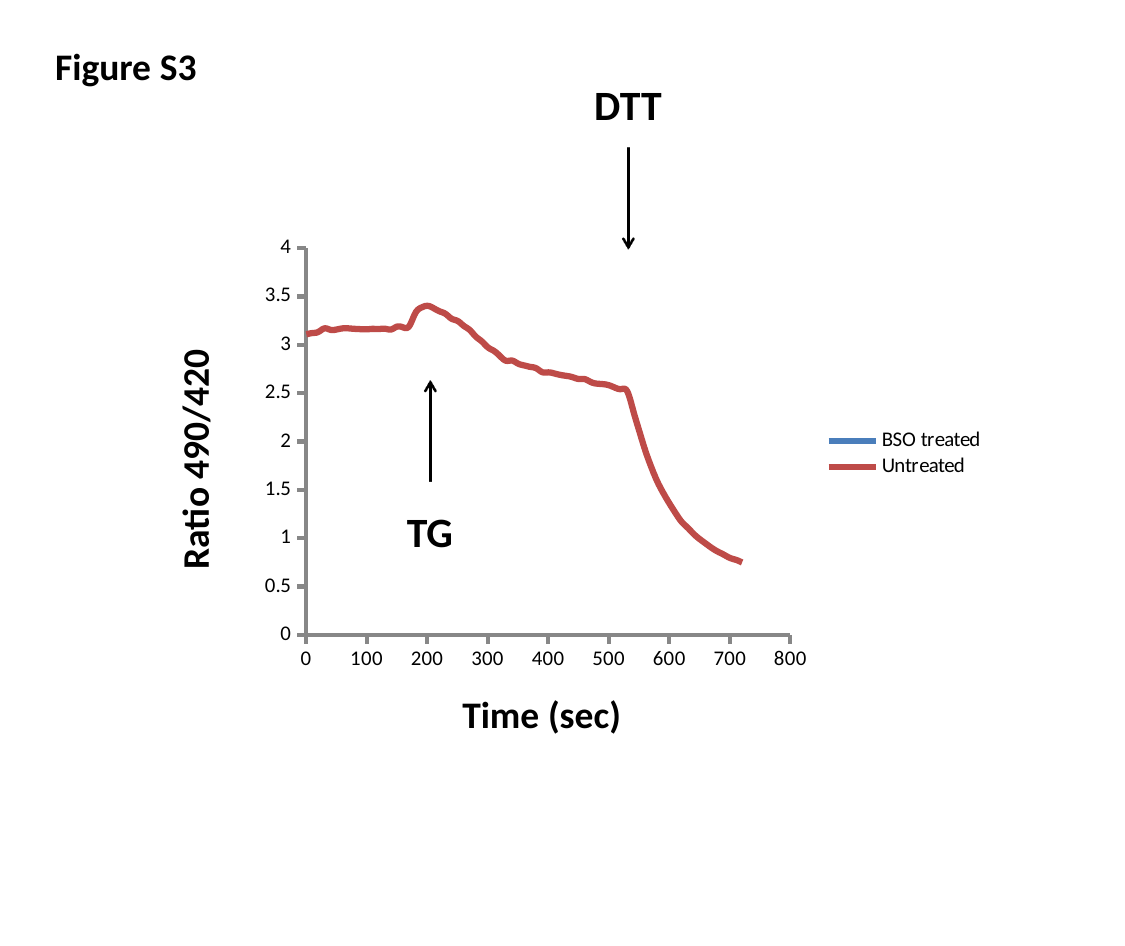
What are the two series named in the legend? BSO treated, Untreated What is the title of the y axis? Ratio 490/420 What kind of chart is shown on the slide? line chart How many series does the legend list? 2 After the DTT arrow (around 530 sec), does the Untreated line rise or fall? fall Is the value of the Untreated line at 0 sec greater or less than 3? greater Is the value of the Untreated line at 200 sec greater or less than 3? greater Which is larger for the Untreated line: the value at 100 sec or the value at 700 sec? 100 sec Is the value of the Untreated line at 400 sec greater or less than 2.5? greater Does the Untreated line overall rise or fall from left to right along the x axis? fall